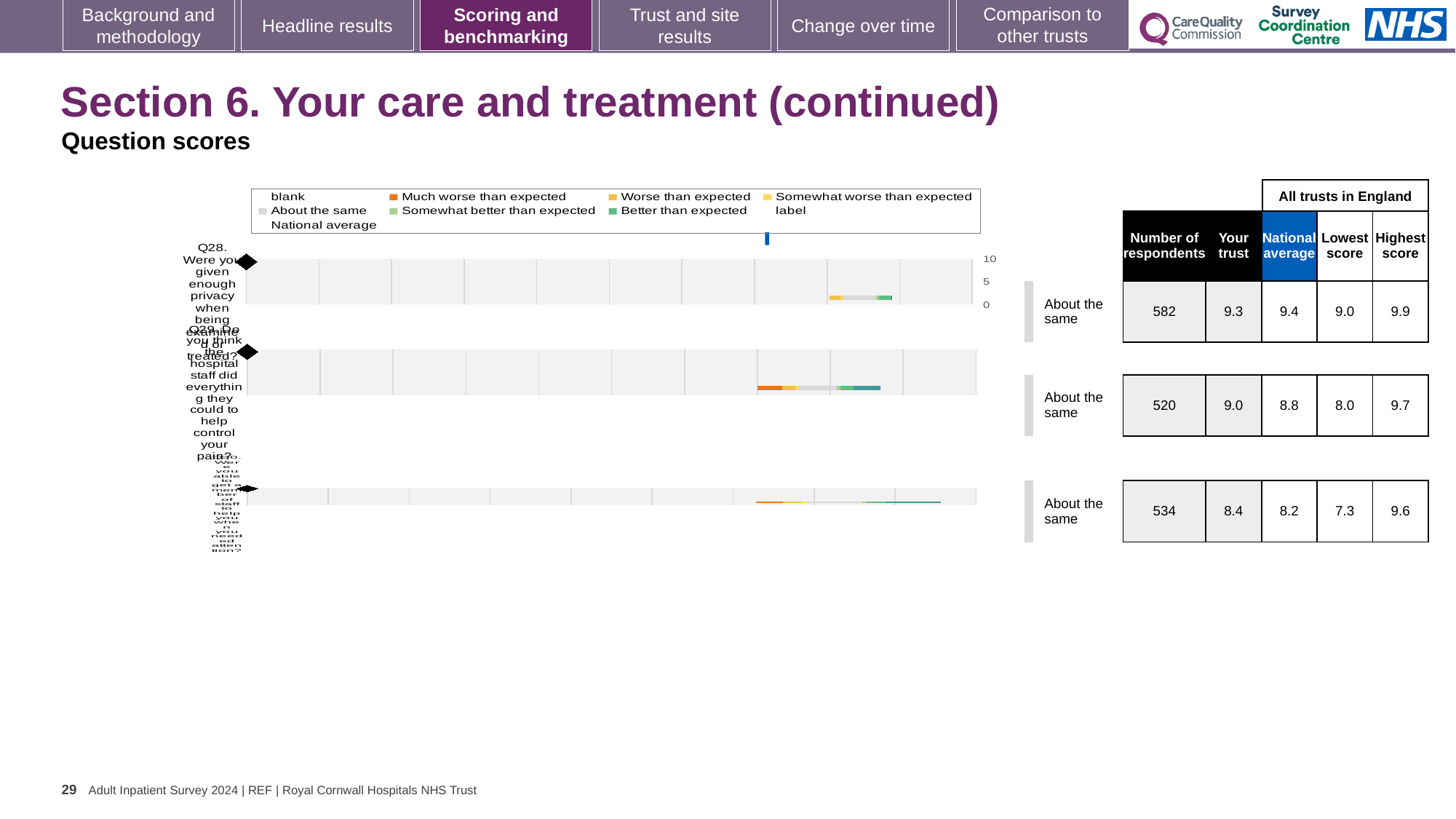
How many questions are shown on the slide? 3 What benchmark category is shown for Q29? About the same What is the national average score for Q29 (Do you think the hospital staff did everything they could to help control your pain?)? 8.8 What is the lowest score among all trusts in England for Q30? 7.3 Which question has the highest 'Your trust' score? Q28 For Q28, what is the difference between the highest score and the lowest score among all trusts in England? 0.9 Is the 'Your trust' score for Q28 greater or less than 5? greater How many respondents answered Q30? 534 Which question has the lowest 'Your trust' score? Q30 For Q29, which is larger: the 'Your trust' score or the national average? Your trust What kind of chart is used to show the question scores? Bar chart What is the 'Your trust' score for Q28 (Were you given enough privacy when being examined or treated?)? 9.3